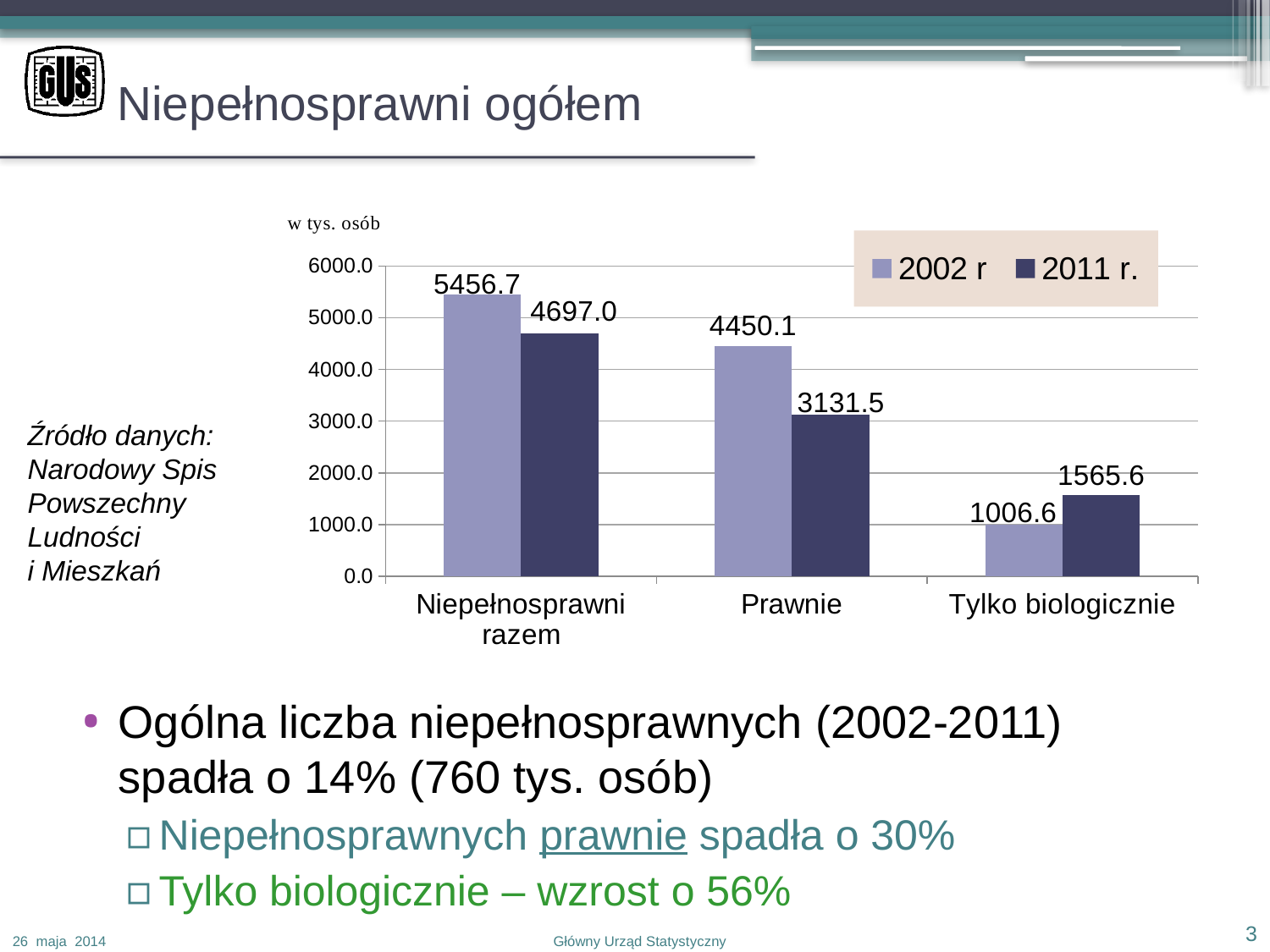
Which category has the highest value in the 2011 r. series? Niepełnosprawni razem What is the value for Tylko biologicznie in 2002 r? 1006.6 Which category has the lowest value in the 2002 r series? Tylko biologicznie What kind of chart is shown on the slide? bar chart What is the difference between the 2002 r and 2011 r. values for Prawnie? 1318.6 What is the difference between the 2002 r and 2011 r. values for Niepełnosprawni razem? 759.7 How many categories are shown on the x axis? 3 For Tylko biologicznie, which is larger: the 2002 r value or the 2011 r. value? 2011 r. What is the value for Prawnie in 2011 r.? 3131.5 What is the value for Tylko biologicznie in 2011 r.? 1565.6 What is the value for Niepełnosprawni razem in 2002 r? 5456.7 How many series does the legend list? 2